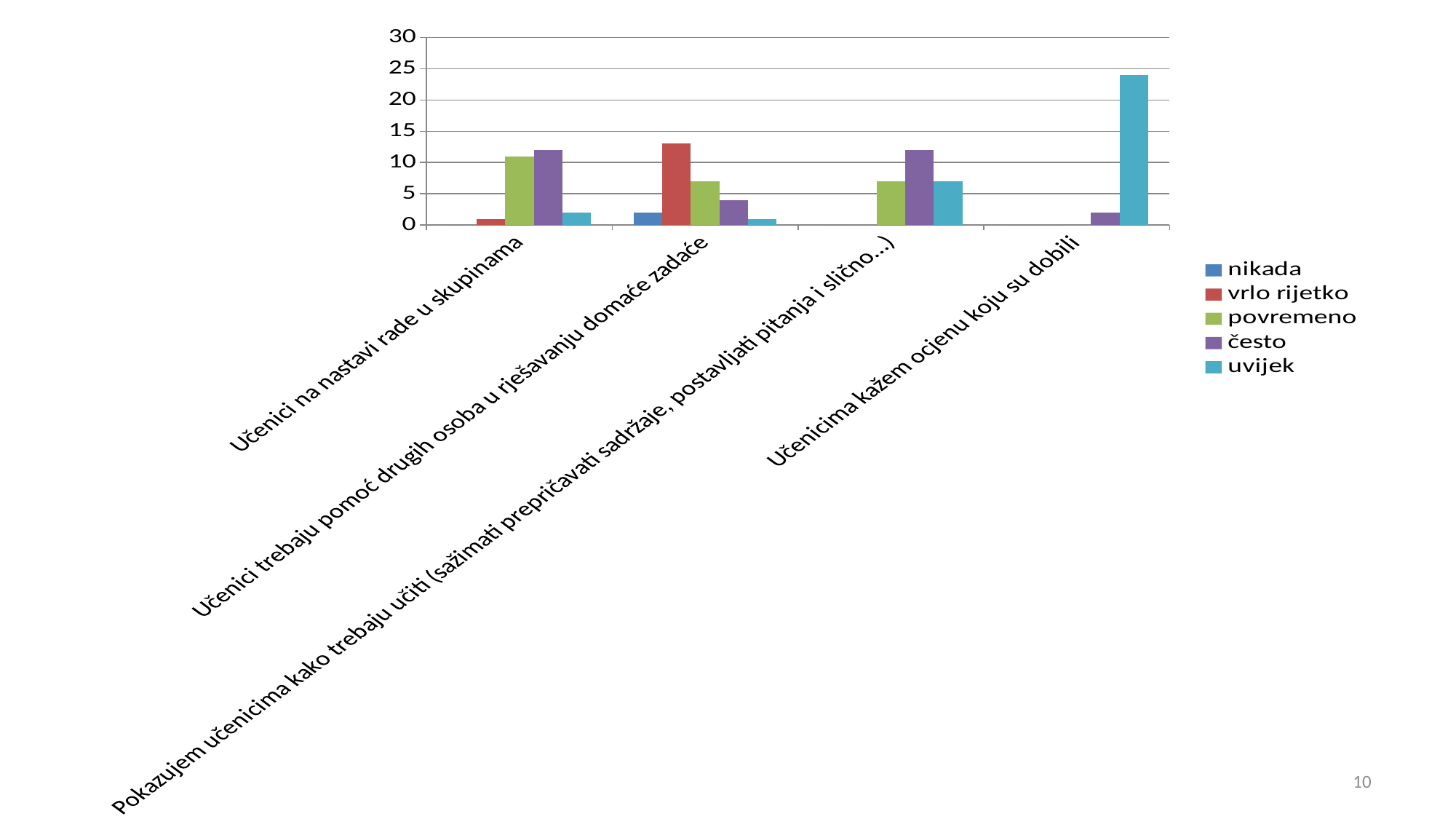
Which category contains the tallest bar in the chart? Učenicima kažem ocjenu koju su dobili Which series has the highest value in the category "Učenicima kažem ocjenu koju su dobili"? uvijek Is the value for "povremeno" in the category "Učenici trebaju pomoć drugih osoba u rješavanju domaće zadaće" greater or less than 10? less Is the value for "vrlo rijetko" in the category "Učenici trebaju pomoć drugih osoba u rješavanju domaće zadaće" greater or less than 10? greater Which series has the highest value in the category "Učenici trebaju pomoć drugih osoba u rješavanju domaće zadaće"? vrlo rijetko Is the value for "često" in the category "Učenici na nastavi rade u skupinama" greater or less than 10? greater In the category "Pokazujem učenicima kako trebaju učiti (sažimati prepričavati sadržaje, postavljati pitanja i slično...)", which is larger: "često" or "uvijek"? često Which series is listed first in the legend? nikada How many series does the legend list? 5 How many categories are shown on the x axis? 4 What kind of chart is shown on the slide? bar chart